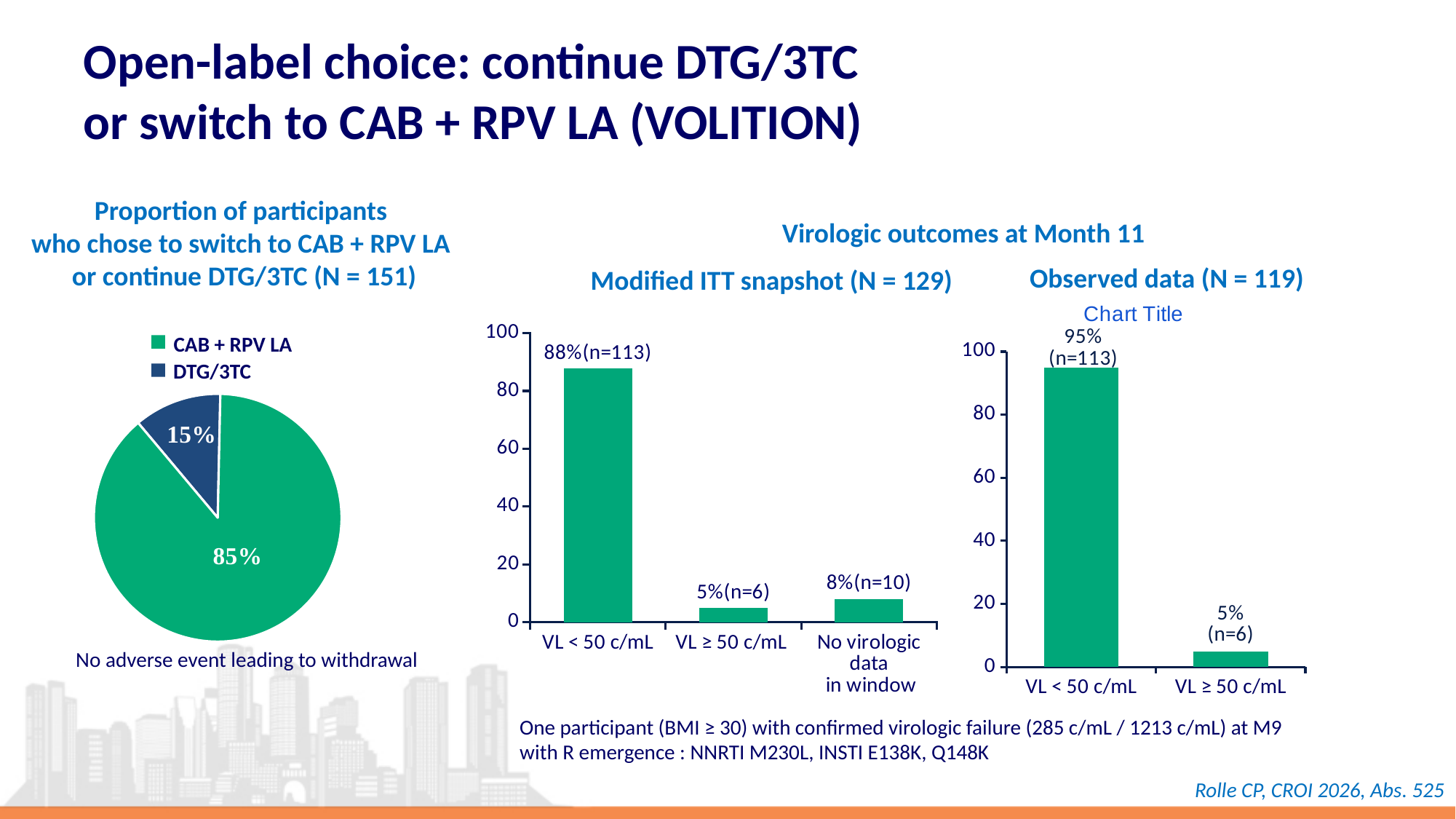
How many entries does the legend of the pie chart on the left list? 2 In the pie chart on the left, what share of participants chose CAB + RPV LA? 85% What kind of chart is the Observed data chart? Bar chart In the Modified ITT snapshot chart, what is the difference in percentage points between VL < 50 c/mL and VL ≥ 50 c/mL? 83 In the Modified ITT snapshot chart, which category has the lowest value? VL ≥ 50 c/mL In the Observed data chart, what is the value for VL ≥ 50 c/mL? 5% (n=6) In the pie chart on the left, what share of participants continued DTG/3TC? 15% In the Modified ITT snapshot chart, what is the value for No virologic data in window? 8%(n=10) In the Observed data chart, what is the value for VL < 50 c/mL? 95% (n=113) In the Modified ITT snapshot chart, what is the value for VL < 50 c/mL? 88%(n=113) How many categories are shown in the Modified ITT snapshot chart? 3 What kind of chart is the chart on the left of the slide? Pie chart